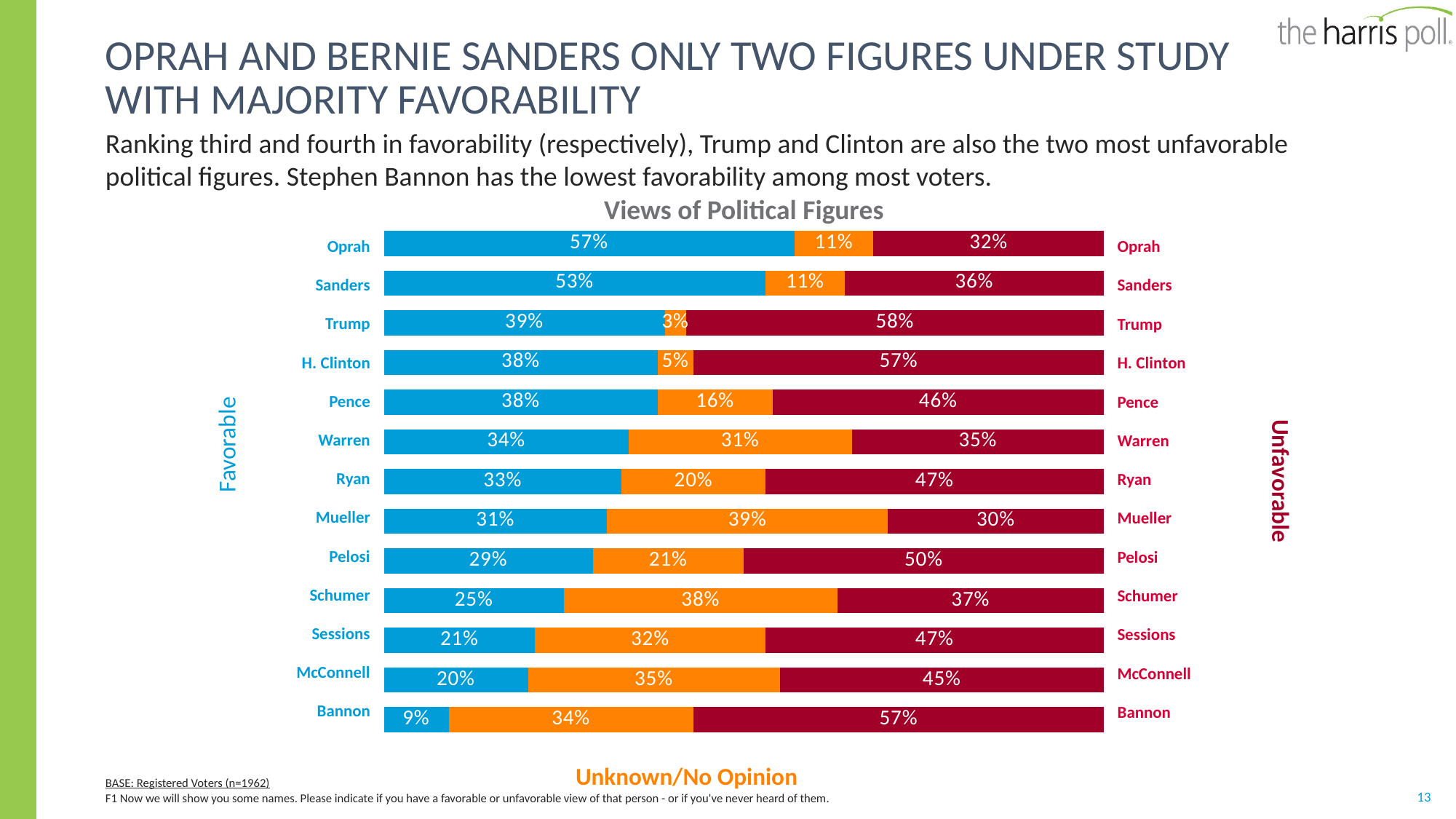
Which political figure has the lowest Favorable value? Bannon Which political figure has the highest Unknown/No Opinion value? Mueller What is the difference between the Favorable values for Oprah and Sanders? 4% Which is larger, the Unfavorable value for Pelosi or the Unfavorable value for Ryan? Pelosi What is the Unknown/No Opinion value for Mueller? 39% What kind of chart is shown on the slide? Stacked bar chart How many political figures are shown in the chart? 13 What is the Favorable value for Oprah? 57% What is the Unfavorable value for Trump? 58% What is the total of the Favorable, Unknown/No Opinion and Unfavorable values for Warren? 100% How many series does the chart show for each political figure? 3 What is the title of the chart? Views of Political Figures